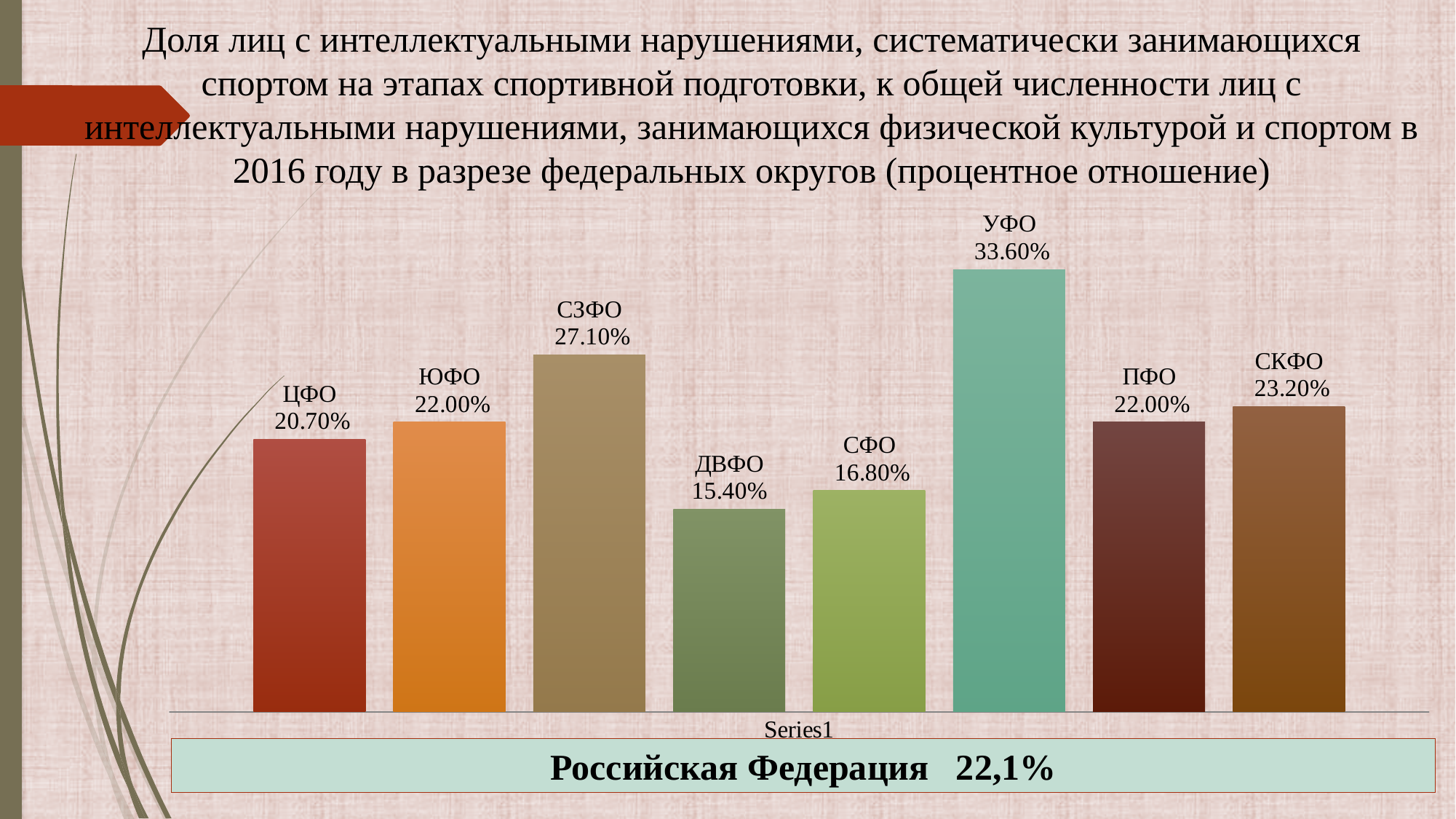
Which federal district has the lowest value? ДВФО Which is larger, the value for СКФО or the value for ЦФО? СКФО What is the value for ЦФО? 20.70% What is the difference between the values for УФО and ДВФО? 18.20% What is the difference between the values for СЗФО and СФО? 10.30% Which federal district has the highest value? УФО What is the value for СКФО? 23.20% What value is given for the Российская Федерация in the box below the chart? 22,1% What kind of chart is shown on the slide? Bar chart How many federal districts are shown in the chart? 8 What is the value for УФО? 33.60% What is the value for ДВФО? 15.40%